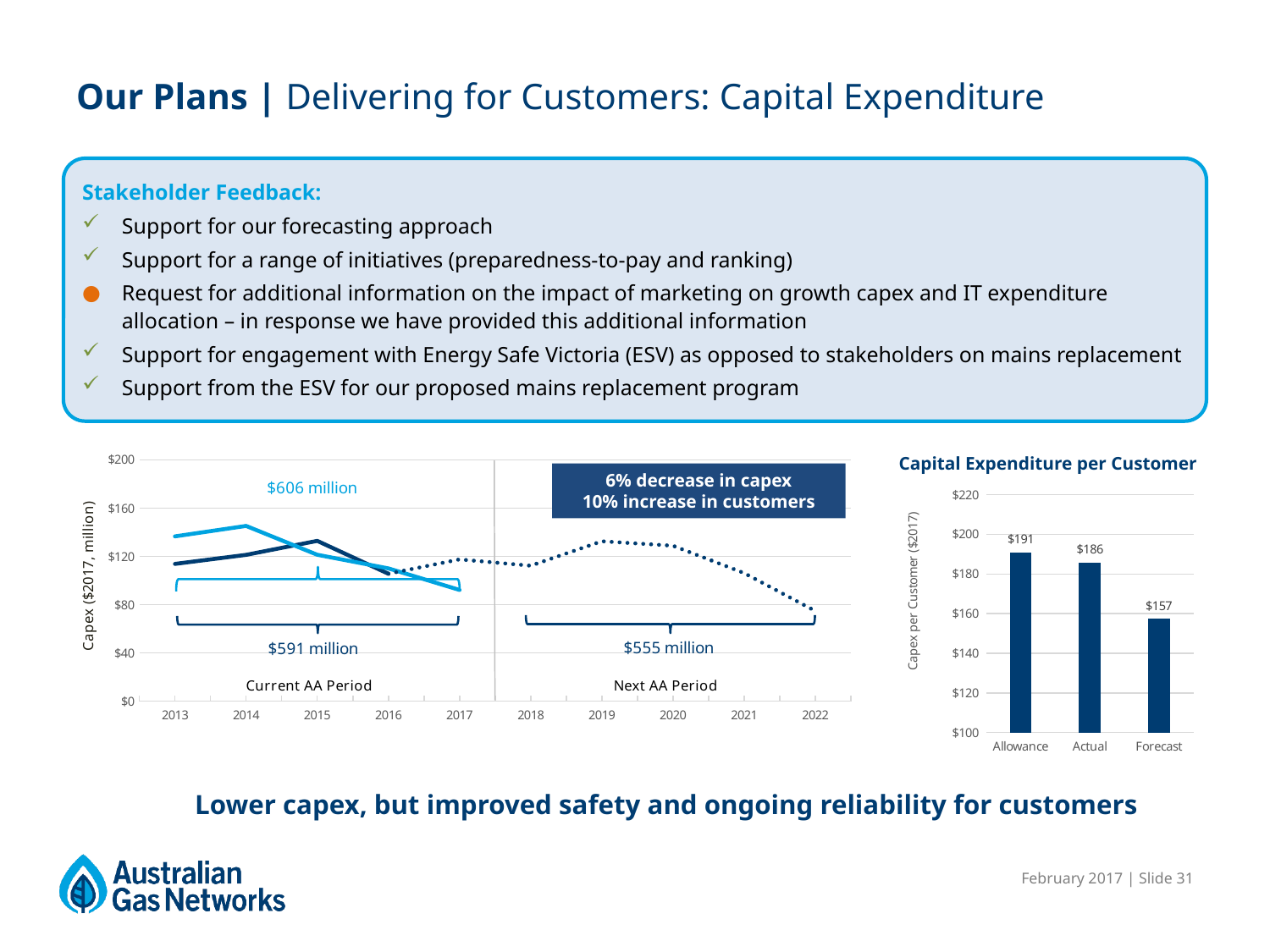
What kind of chart is the chart on the left of the slide showing Capex ($2017, million) by year? Line chart In the Capital Expenditure per Customer chart, which category has the highest value? Allowance What kind of chart is the Capital Expenditure per Customer chart? Bar chart In the Capital Expenditure per Customer chart, what is the value for Actual? $186 In the Capital Expenditure per Customer chart, what is the value for Allowance? $191 In the Capital Expenditure per Customer chart, which category has the lowest value? Forecast In the Capital Expenditure per Customer chart, what is the difference between the Actual and Forecast values? $29 In the Capital Expenditure per Customer chart, what is the difference between the Allowance and Forecast values? $34 In the Capital Expenditure per Customer chart, how many categories are shown? 3 In the left-hand capex line chart, what total is labelled for the Next AA Period? $555 million In the left-hand capex line chart, is the dotted forecast value for 2019 greater or less than $120? greater In the Capital Expenditure per Customer chart, what is the value for Forecast? $157